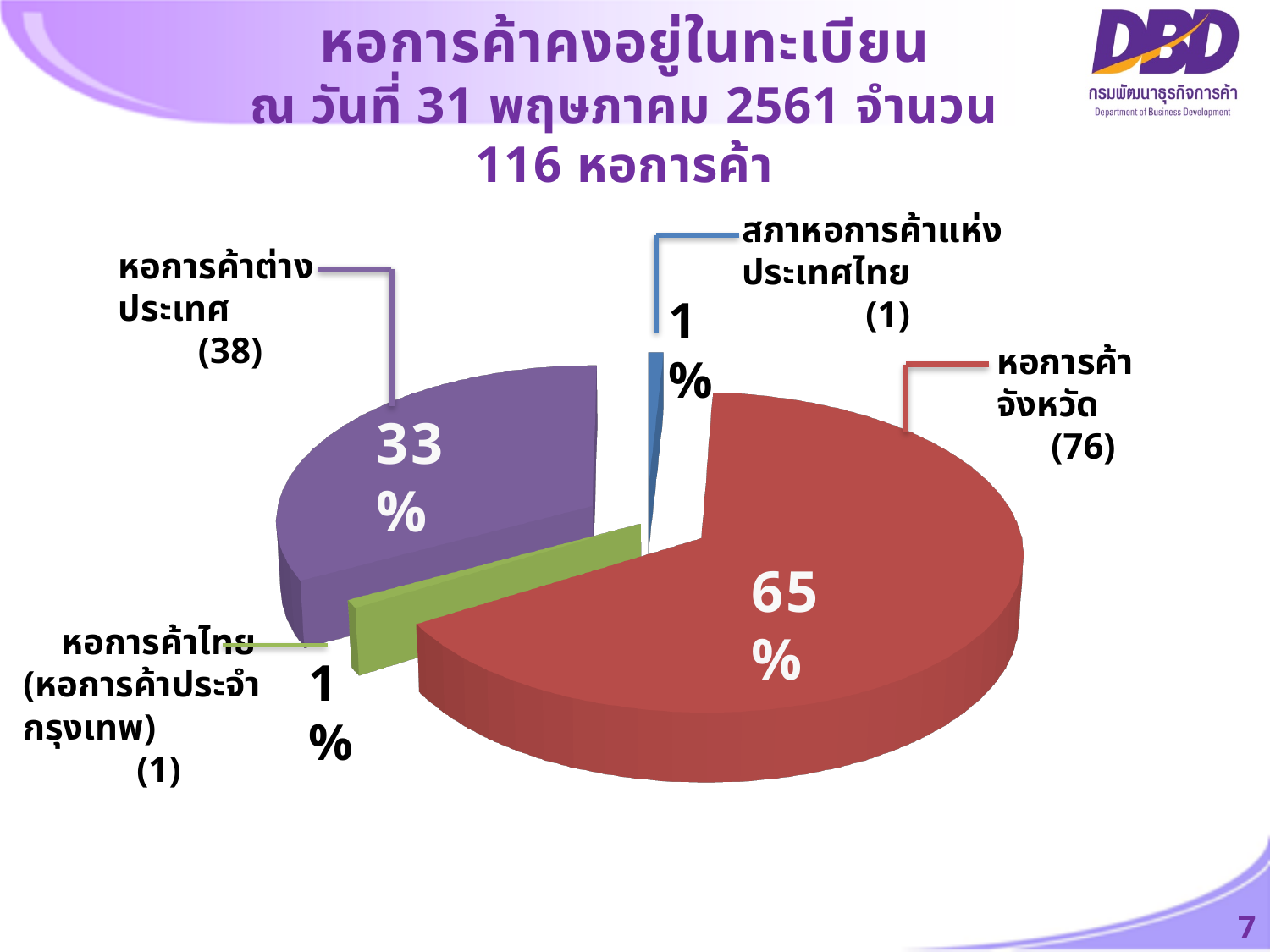
What is the difference in count between หอการค้าจังหวัด and หอการค้าต่างประเทศ? 38 How many chambers are counted for หอการค้าต่างประเทศ? 38 What percentage share does หอการค้าต่างประเทศ have in the pie chart? 33% How many slices does the pie chart have? 4 What percentage share does หอการค้าจังหวัด have in the pie chart? 65% What percentage share does สภาหอการค้าแห่งประเทศไทย have in the pie chart? 1% How many chambers are counted for หอการค้าจังหวัด? 76 Which is larger, the slice for หอการค้าต่างประเทศ or the slice for หอการค้าจังหวัด? หอการค้าจังหวัด Which category has the largest slice of the pie chart? หอการค้าจังหวัด How many chambers are counted for หอการค้าไทย (หอการค้าประจำกรุงเทพ)? 1 What is the total number of chambers of commerce stated in the slide title? 116 What kind of chart is shown on the slide? Pie chart